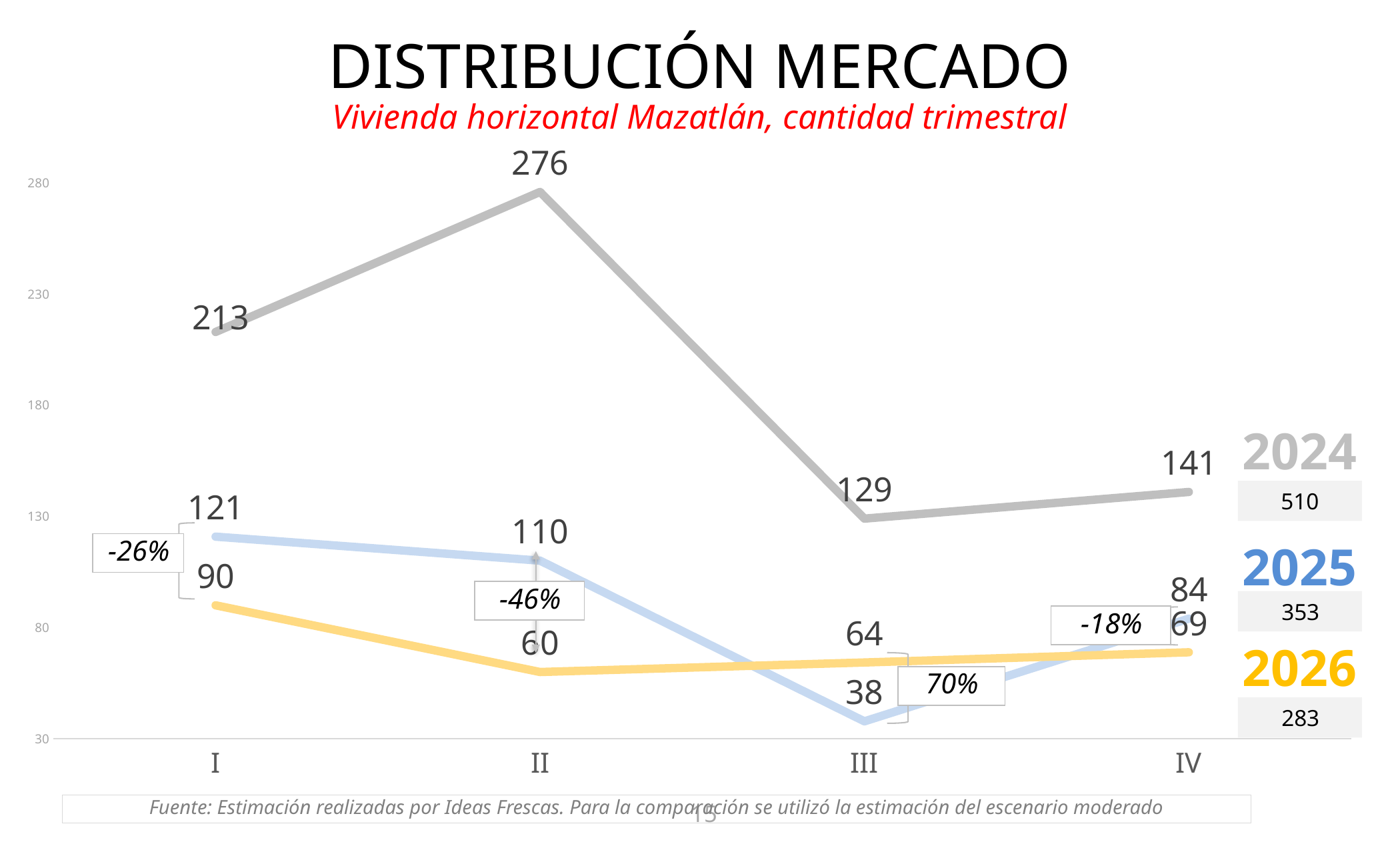
What is the difference between the 2024 and 2025 values in quarter I? 92 What is the value for quarter II in the 2024 series? 276 How many quarters are plotted on the x axis? 4 How many series (years) are plotted on the chart? 3 What is the value for quarter III in the 2025 series? 38 What percentage change is shown between the 2025 and 2026 values in quarter II? -46% Which quarter has the lowest value in the 2025 series? III What is the value for quarter I in the 2026 series? 90 Which quarter has the highest value in the 2024 series? II Which is larger in quarter III, the 2025 value or the 2026 value? 2026 What type of chart is shown on the slide? line chart What annual total is shown next to the 2025 label? 353